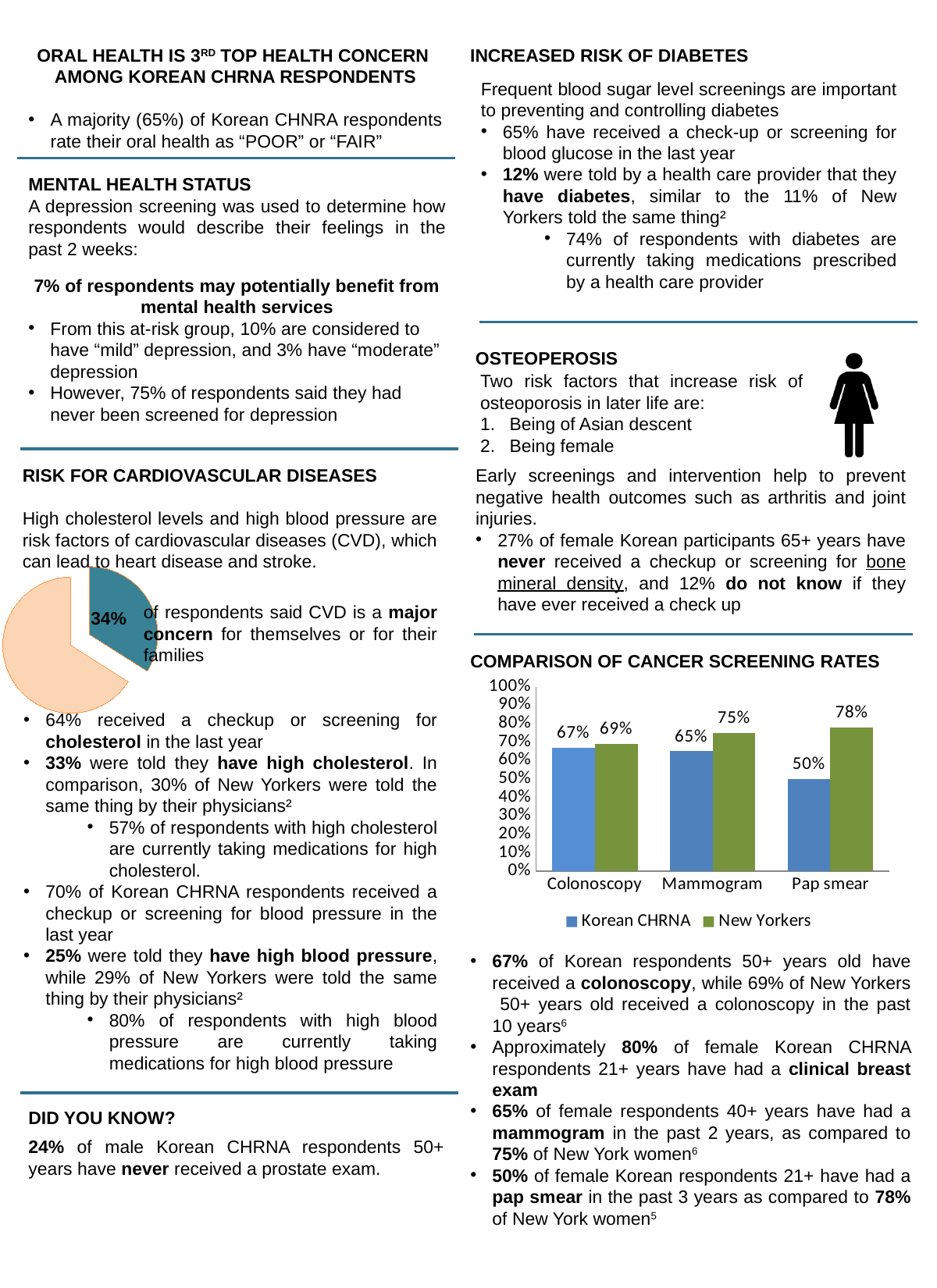
In the 'Comparison of Cancer Screening Rates' chart, what is the difference between New Yorkers and Korean CHRNA for Pap smear? 28% In the 'Comparison of Cancer Screening Rates' chart, which category has the highest value for New Yorkers? Pap smear In the 'Comparison of Cancer Screening Rates' chart, what is the difference between New Yorkers and Korean CHRNA for Mammogram? 10% What kind of chart is the 'Comparison of Cancer Screening Rates' chart? Bar chart In the 'Comparison of Cancer Screening Rates' chart, what is the value for New Yorkers for Pap smear? 78% In the 'Comparison of Cancer Screening Rates' chart, how many categories are shown on the x axis? 3 In the 'Comparison of Cancer Screening Rates' chart, how many series does the legend list? 2 In the pie chart in the 'Risk for Cardiovascular Diseases' section, what share is shown for the labeled slice? 34% In the 'Comparison of Cancer Screening Rates' chart, which is larger for Mammogram: Korean CHRNA or New Yorkers? New Yorkers In the 'Comparison of Cancer Screening Rates' chart, what is the value for Korean CHRNA for Colonoscopy? 67% In the 'Comparison of Cancer Screening Rates' chart, which category has the lowest value for Korean CHRNA? Pap smear In the 'Comparison of Cancer Screening Rates' chart, what is the value for New Yorkers for Mammogram? 75%